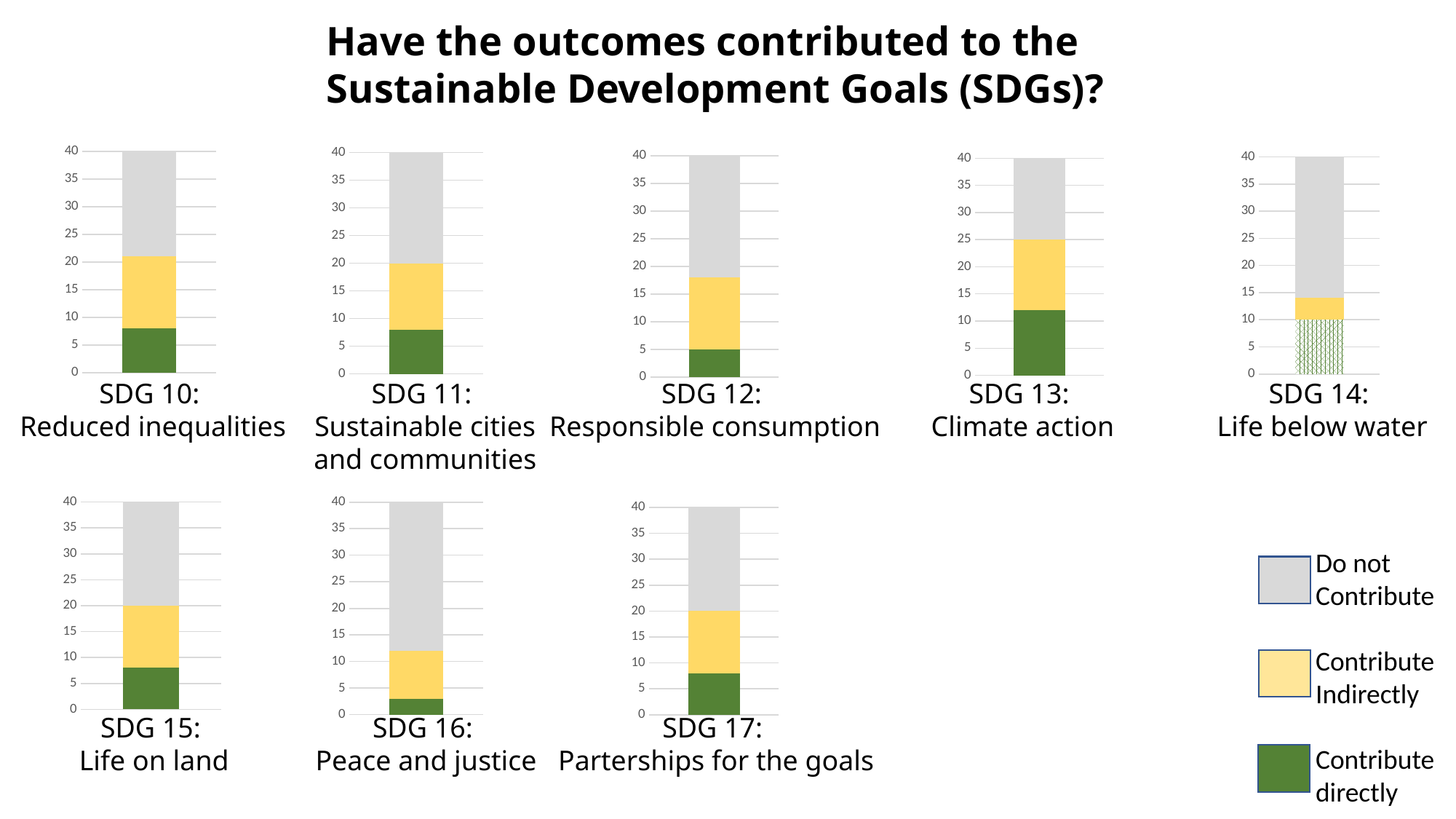
In the SDG 14: Life below water chart, what is the value of the Contribute directly segment? 10 Which SDG chart has the smallest Contribute directly segment? SDG 16: Peace and justice In the SDG 12: Responsible consumption chart, what is the value of the Contribute directly segment? 5 Which colour represents Contribute directly in the legend? green In the SDG 10: Reduced inequalities chart, is the Contribute directly value greater or less than 5? greater In the SDG 16: Peace and justice chart, is the Contribute directly value greater or less than 5? less How many series does the legend list? 3 What kind of chart is used for SDG 10: Reduced inequalities? stacked bar chart In the SDG 13: Climate action chart, is the Contribute directly value greater or less than 10? greater In the SDG 13: Climate action chart, what is the total height of the stacked bar? 40 How many SDG charts are shown on the slide? 8 Is the Contribute directly segment larger for SDG 13: Climate action or for SDG 16: Peace and justice? SDG 13: Climate action